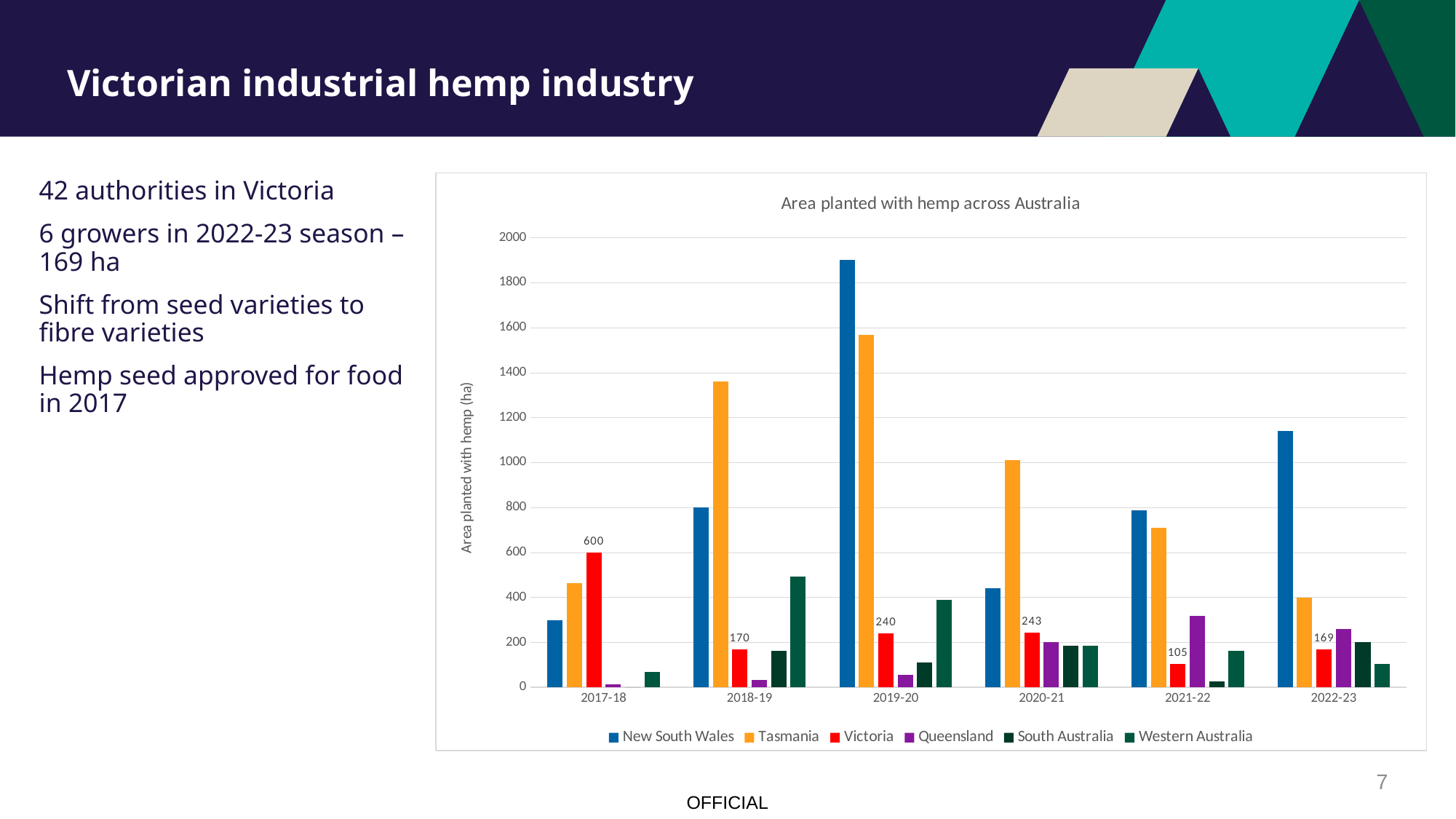
What is the difference between Victoria's area planted in 2017-18 and 2018-19? 430 What kind of chart is shown on the slide? Bar chart What is the area planted with hemp in Victoria in 2022-23? 169 What is the area planted with hemp in Victoria in 2017-18? 600 What is the area planted with hemp in Victoria in 2021-22? 105 Which is larger: Victoria's area planted in 2020-21 or in 2021-22? 2020-21 How many series does the legend list? 6 Is the value for New South Wales in 2019-20 greater or less than 1800? greater Is the value for Tasmania in 2018-19 greater or less than 1200? greater How many seasons are shown on the x axis? 6 In which season was the area planted with hemp in Victoria lowest? 2021-22 In which season was the area planted with hemp in Victoria highest? 2017-18